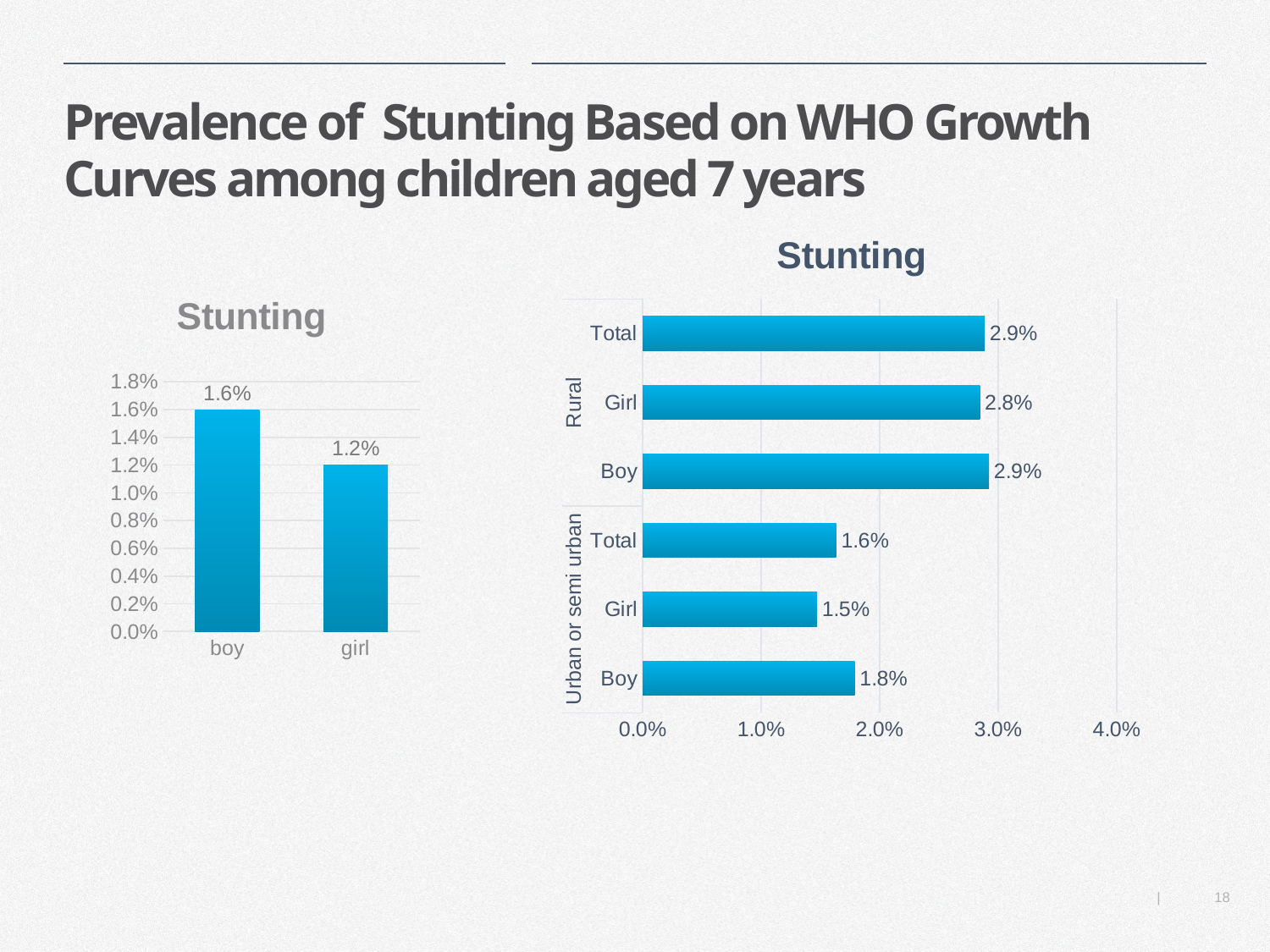
In the right-hand chart, what is the value for Urban or semi urban Girl? 1.5% In the left-hand chart, which category has the higher value, boy or girl? boy In the left-hand chart, what is the stunting value for girl? 1.2% In the right-hand chart, which bar has the lowest value? Urban or semi urban Girl What kind of chart is the left-hand chart? bar chart In the right-hand chart, is the value for Rural Girl greater or less than 2.0%? greater In the right-hand chart, what is the value for Rural Total? 2.9% In the left-hand chart, what is the stunting value for boy? 1.6% In the left-hand chart, what is the difference between the boy and girl values? 0.4% How many bars are plotted in the right-hand chart? 6 In the right-hand chart, what is the value for Urban or semi urban Boy? 1.8% In the right-hand chart, what is the difference between the Rural Total and the Urban or semi urban Total? 1.3%